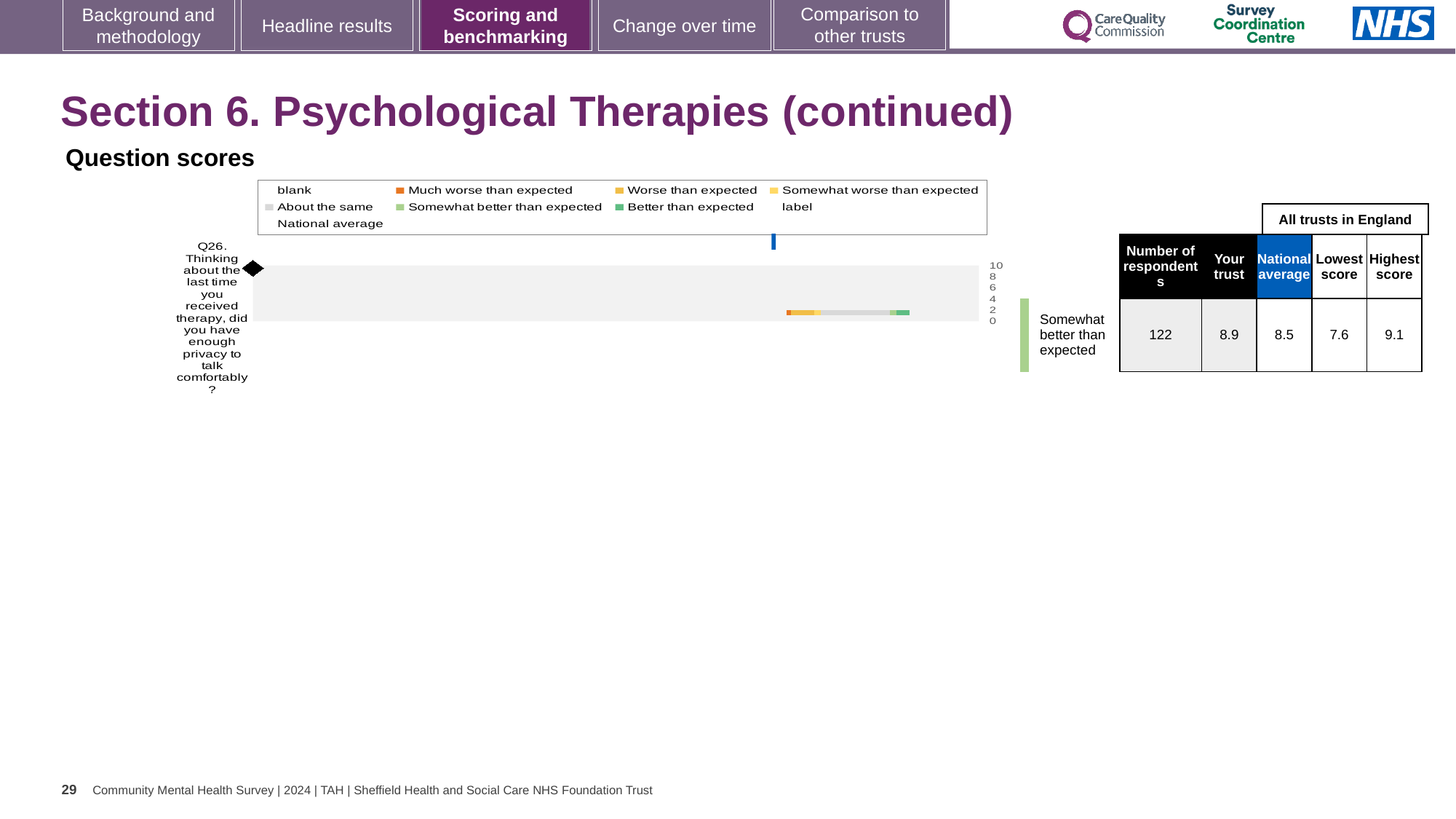
In the table beside the chart, what is the National average score for Q26? 8.5 In the table beside the chart, what is the "Your trust" score for Q26? 8.9 In the table beside the chart, what is the Highest score among all trusts in England for Q26? 9.1 Which is larger for Q26, the Your trust score or the National average score? Your trust In the table beside the chart, what is the Lowest score among all trusts in England for Q26? 7.6 What kind of chart is shown under "Question scores"? bar chart What benchmark category is given for Q26 next to the chart? Somewhat better than expected What is the difference between the Your trust score and the National average score for Q26? 0.4 How many questions (categories) are plotted in the Question scores chart? 1 In the table beside the chart, how many respondents answered Q26? 122 Which question number is plotted in the Question scores chart? Q26 What is the highest value shown on the chart's score axis? 10